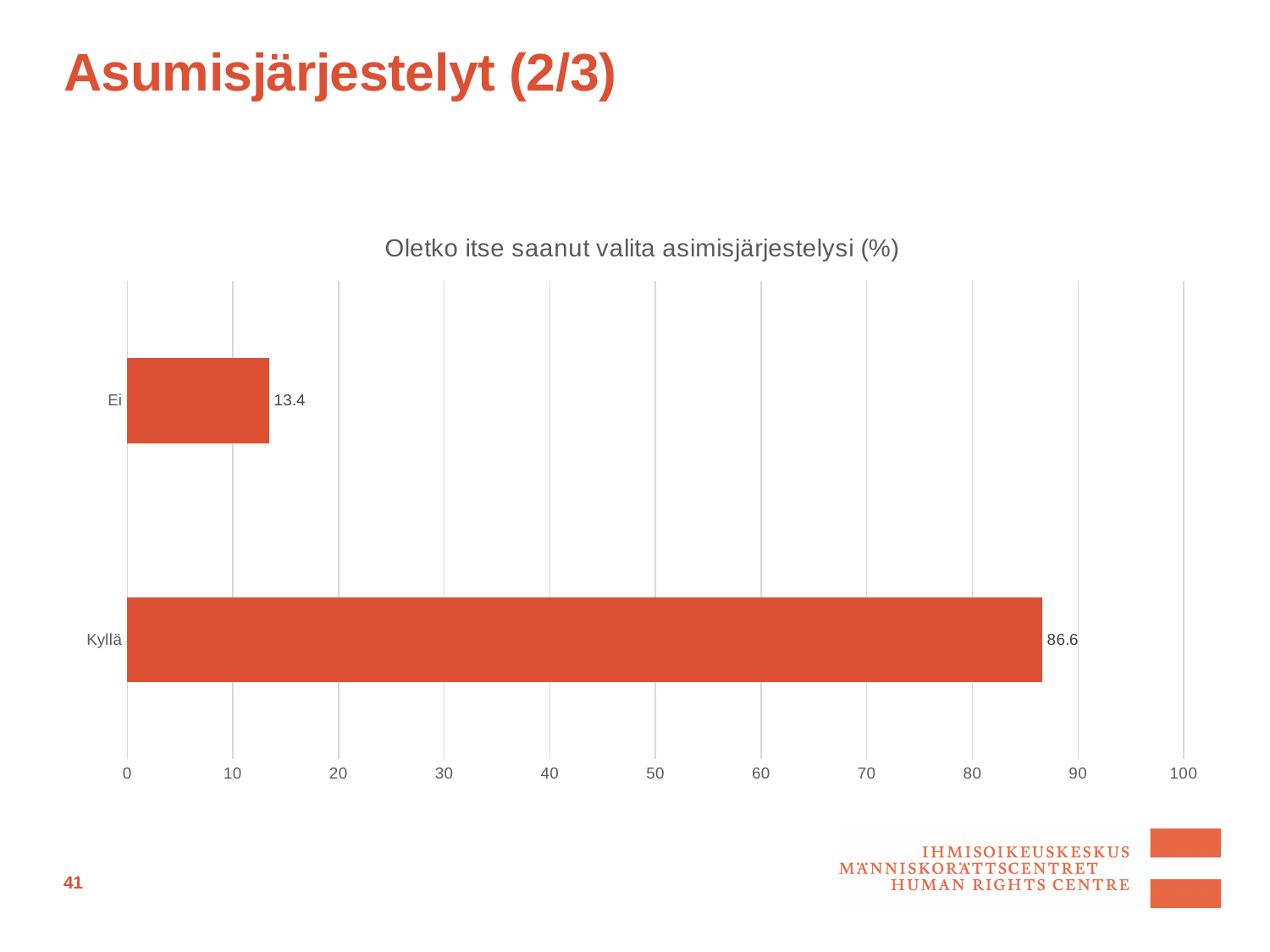
Is the value for Kyllä greater or less than 80? greater What is the title of the chart? Oletko itse saanut valita asimisjärjestelysi (%) What kind of chart is shown on the slide? bar chart What is the difference between the values for Kyllä and Ei? 73.2 What is the value for Ei? 13.4 Which category has the lowest value? Ei What is the maximum value shown on the x axis? 100 How many categories are shown in the chart? 2 Is the value for Ei greater or less than 20? less What is the value for Kyllä? 86.6 Which is larger, the value for Kyllä or the value for Ei? Kyllä Which category has the highest value? Kyllä